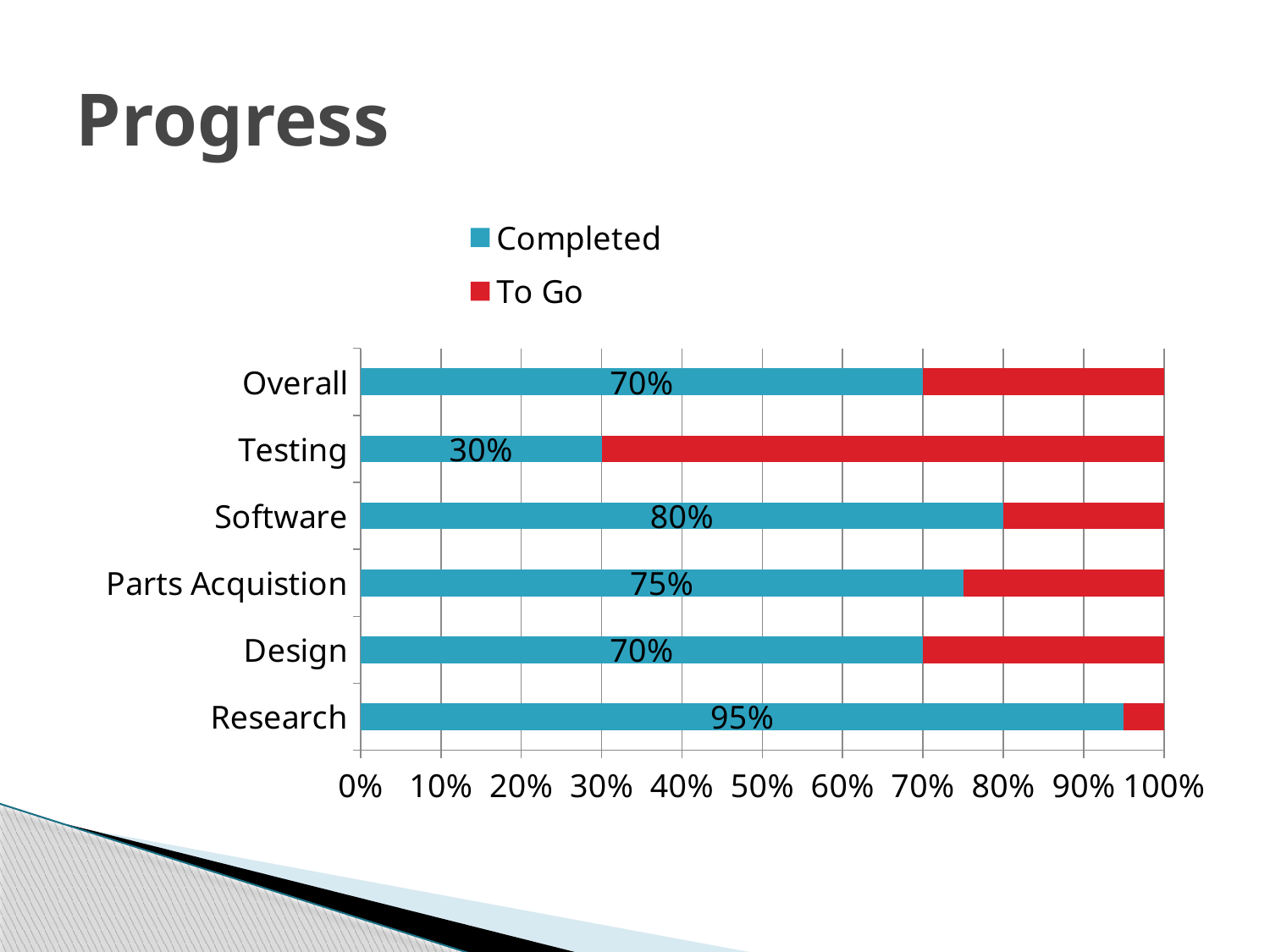
What is the difference between the Completed values for Research and Testing? 65% How many series does the legend list? 2 Which category has the highest Completed value? Research What is the Completed value for Research? 95% What is the Completed value for Testing? 30% What is the Completed value for Software? 80% Is the To Go value for Testing greater or less than 50%? greater What is the Completed value for Parts Acquistion? 75% What kind of chart is shown on the slide? Stacked bar chart How many categories are shown on the chart? 6 Which has a larger Completed value, Software or Design? Software Which category has the lowest Completed value? Testing